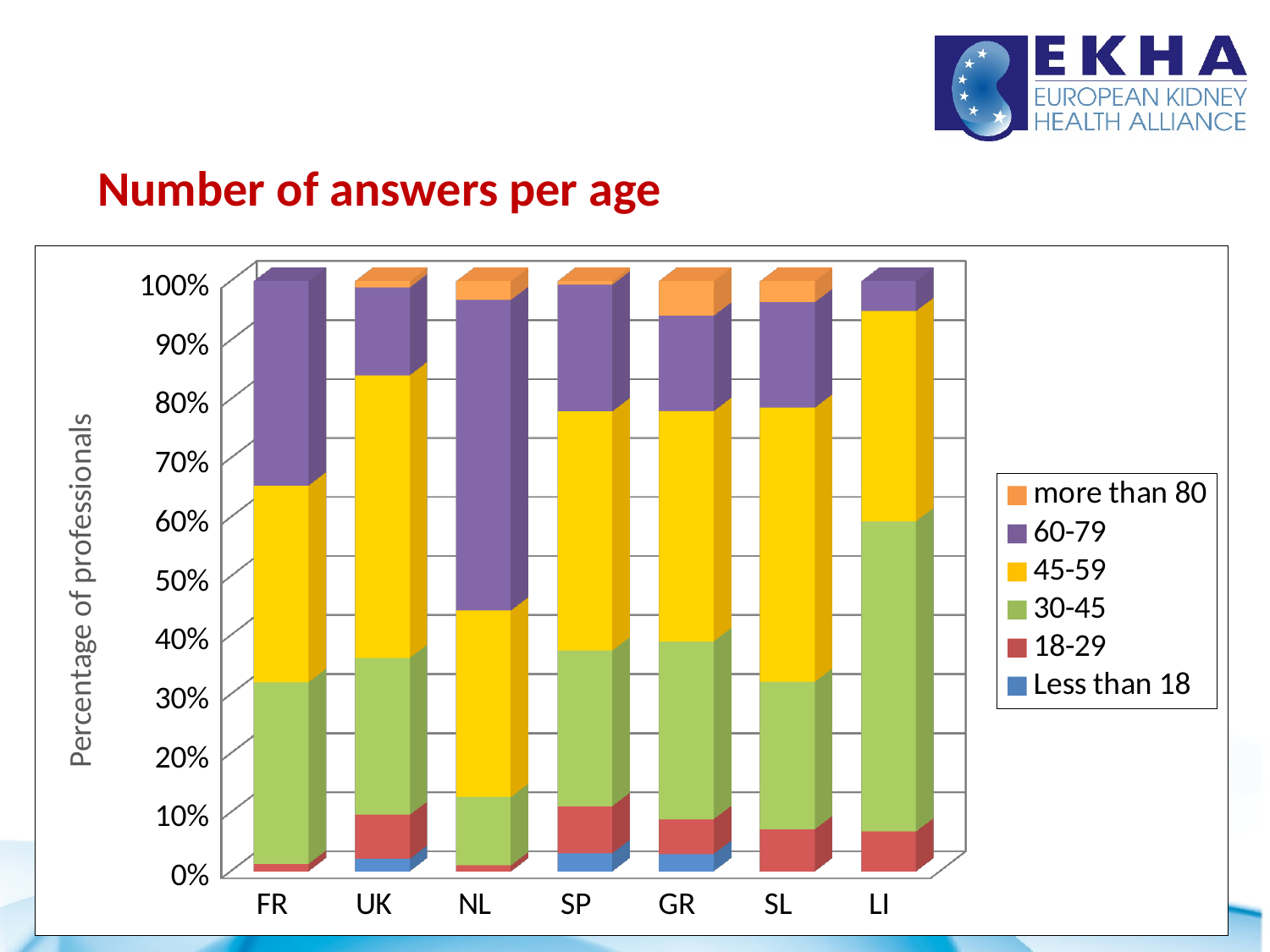
Which country has the largest share of professionals aged 60-79? NL How many age groups does the legend list? 6 Which country has a larger share of professionals aged 60-79, FR or UK? FR Which country has the largest share of professionals aged 30-45? LI What kind of chart is shown on the slide? Stacked bar chart Which country has the smallest share of professionals aged 30-45? NL What is the label of the vertical axis? Percentage of professionals Is the 30-45 share for NL greater or less than 20%? less Is the 60-79 share for NL greater or less than 40%? greater How many countries are shown on the x axis of the chart? 7 Is the 30-45 share for LI greater or less than 50%? greater What is the title of the chart? Number of answers per age